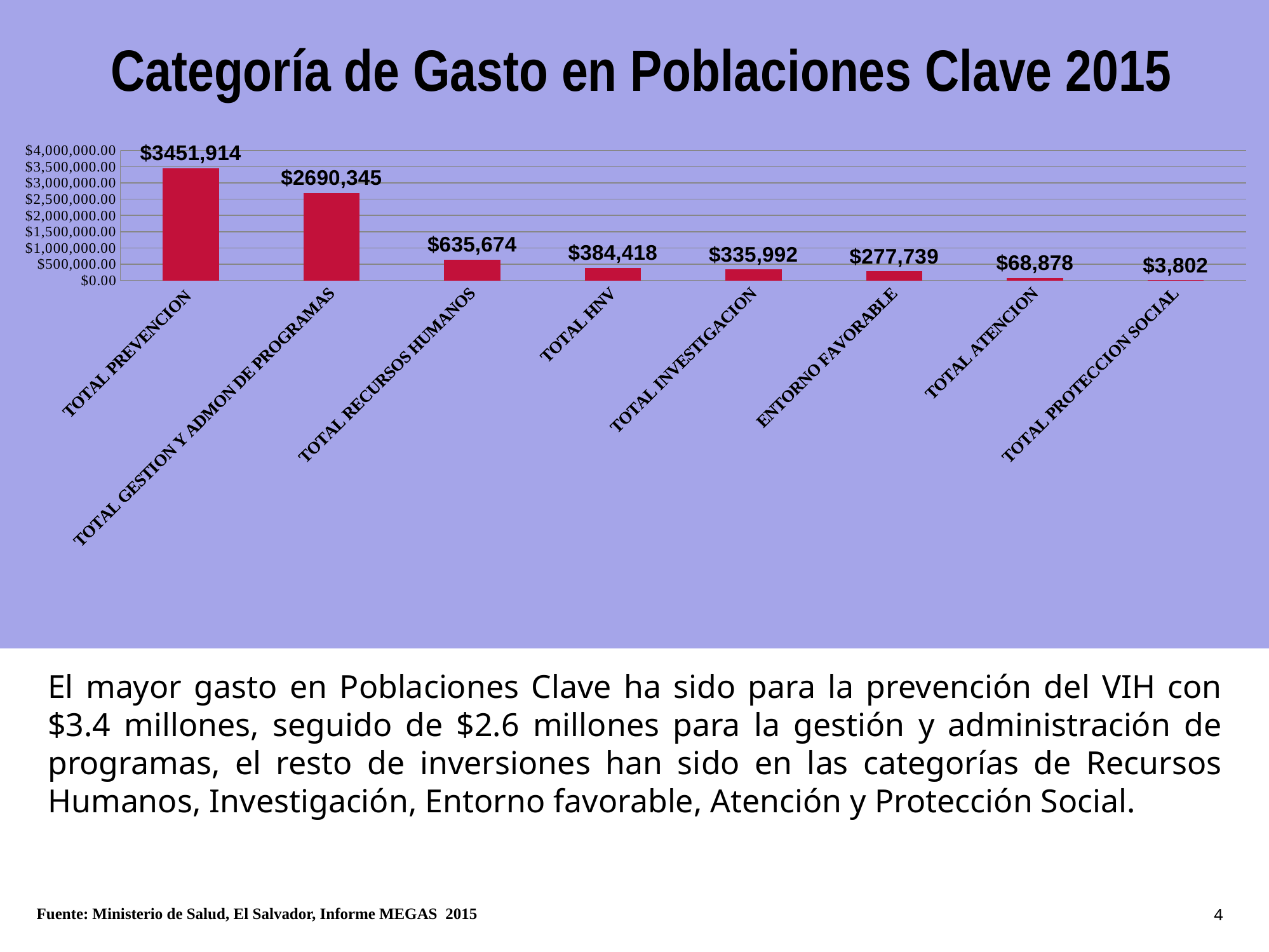
What is the difference between TOTAL ATENCION and TOTAL PROTECCION SOCIAL? $65,076 What kind of chart is shown on the slide? Bar chart Which is larger, TOTAL HNV or TOTAL INVESTIGACION? TOTAL HNV What is the value for TOTAL ATENCION? $68,878 What is the difference between TOTAL PREVENCION and TOTAL GESTION Y ADMON DE PROGRAMAS? $761,569 How many categories are shown in the chart? 8 What is the value for TOTAL PREVENCION? $3451,914 Which category has the highest value? TOTAL PREVENCION Do the values rise or fall from left to right along the x axis? Fall What is the value for TOTAL RECURSOS HUMANOS? $635,674 Which category has the lowest value? TOTAL PROTECCION SOCIAL What is the value for ENTORNO FAVORABLE? $277,739